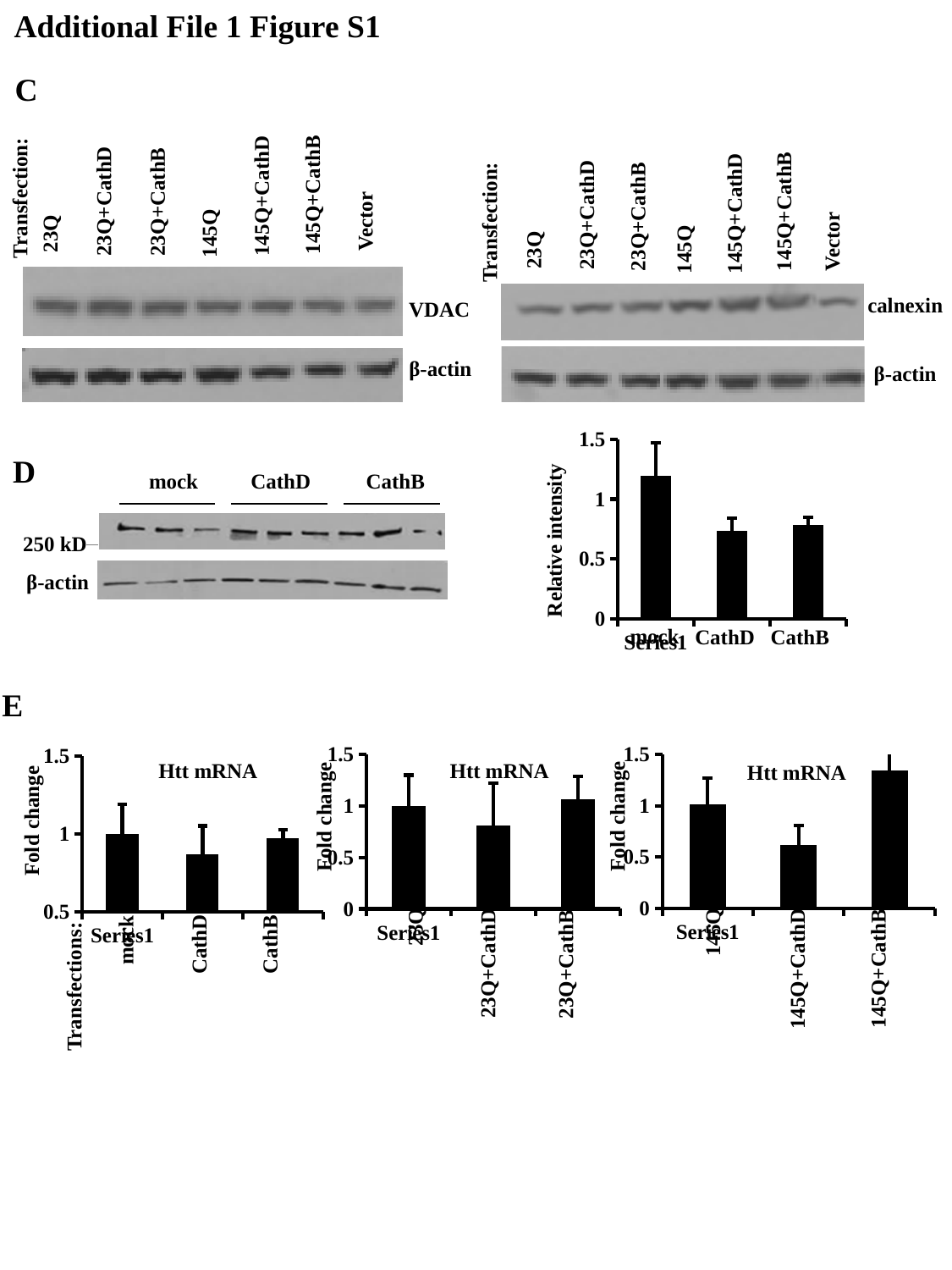
In the Relative intensity bar chart in panel D, is the value for mock greater or less than 1? greater In the leftmost Htt mRNA chart in panel E, which category has the lowest bar? CathD What kind of chart is the Relative intensity chart in panel D? bar chart In the rightmost Htt mRNA chart in panel E, is the value for 145Q+CathD greater or less than 1? less In the leftmost Htt mRNA chart in panel E, is the value for CathD greater or less than 1? less In the rightmost Htt mRNA chart in panel E, which is larger, the value for 145Q+CathB or 145Q+CathD? 145Q+CathB In the rightmost Htt mRNA chart in panel E, which category has the highest bar? 145Q+CathB What is the y-axis label of the three Htt mRNA charts in panel E? Fold change In the middle Htt mRNA chart in panel E, which category has the lowest bar? 23Q+CathD How many bars are plotted in the Relative intensity bar chart in panel D? 3 In the Relative intensity bar chart in panel D, which category has the highest bar? mock